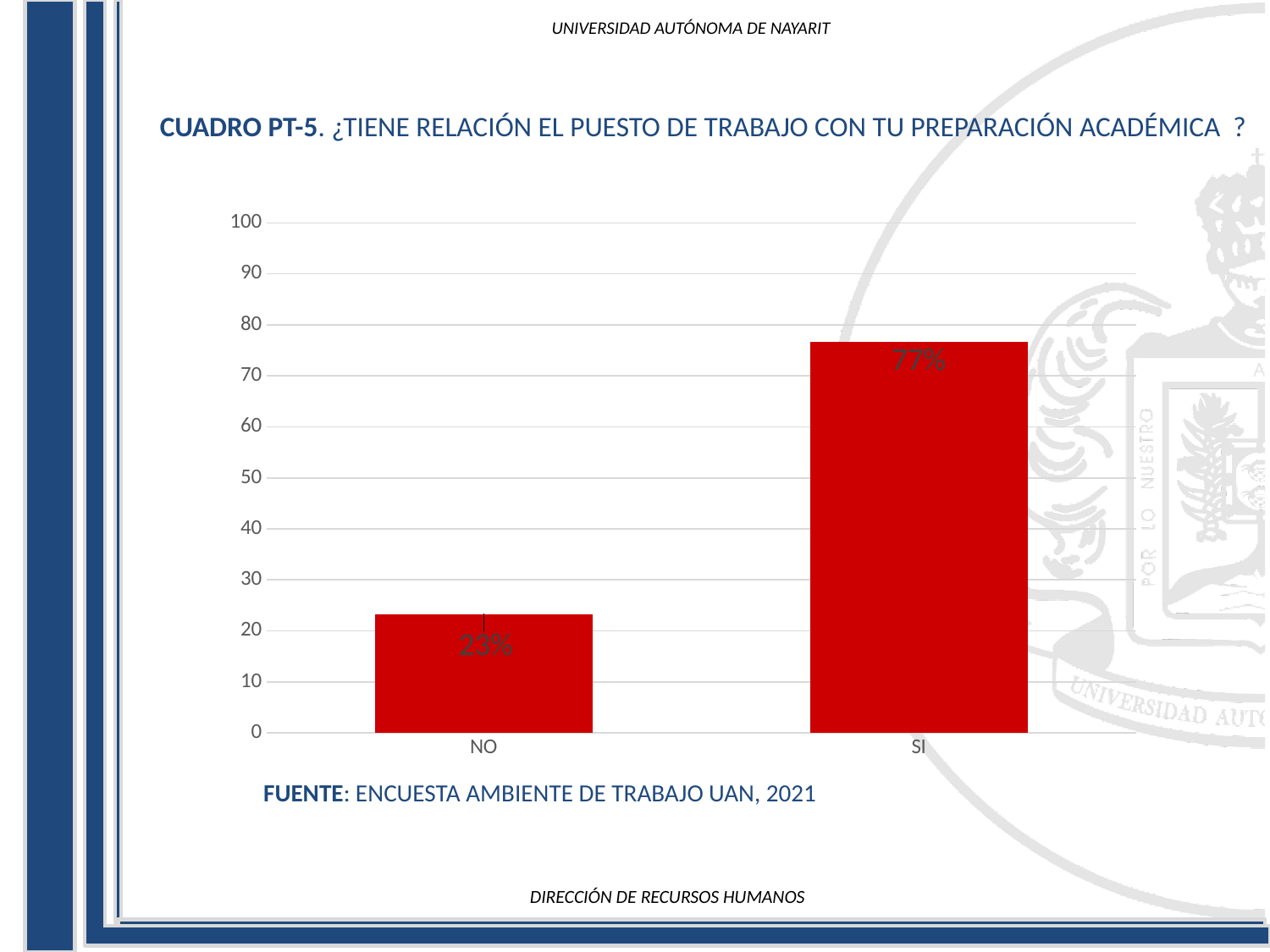
What colour are the bars in the chart? red Is the value for NO greater or less than 30? less Is the value for SI greater or less than 70? greater What is the value for NO? 23% What kind of chart is shown on the slide? bar chart What is the source cited below the chart? ENCUESTA AMBIENTE DE TRABAJO UAN, 2021 Which category has the highest value? SI What is the difference between the values for SI and NO? 54% Which category has the lowest value? NO How many categories are shown on the x axis? 2 What is the value for SI? 77% Which is larger, the value for NO or the value for SI? SI